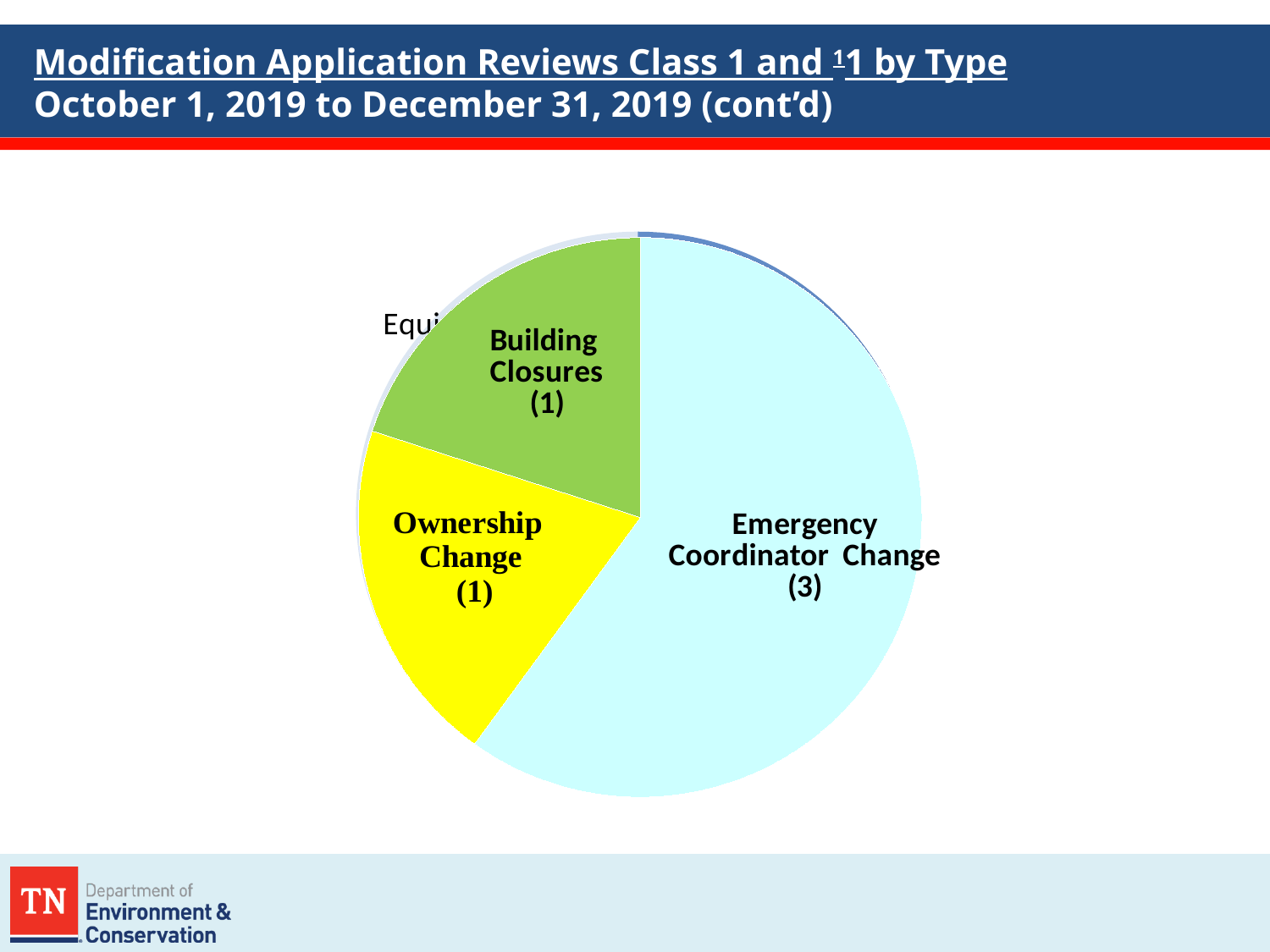
Which category has the largest slice of the pie? Emergency Coordinator Change What type of chart is shown on the slide? Pie chart What colour is the Ownership Change slice? Yellow What is the value shown for Ownership Change? 1 Which is larger, Emergency Coordinator Change or Building Closures? Emergency Coordinator Change What is the value shown for Emergency Coordinator Change? 3 Which is larger, Emergency Coordinator Change or Ownership Change? Emergency Coordinator Change What is the difference between the values for Emergency Coordinator Change and Building Closures? 2 What is the value shown for Building Closures? 1 What date range does the slide title give for the modification application reviews? October 1, 2019 to December 31, 2019